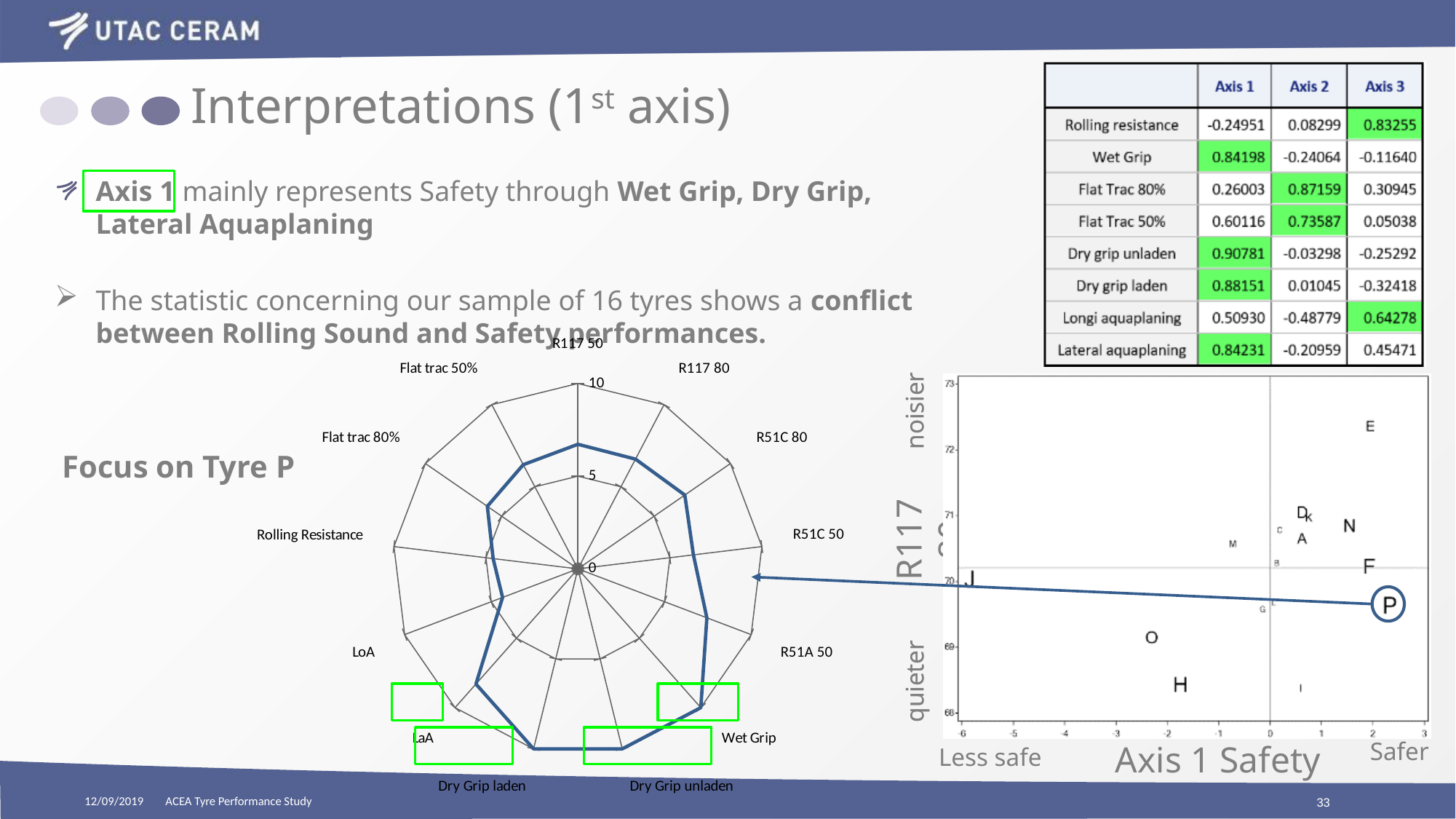
On the 'Focus on Tyre P' radar chart, is the value for R117 50 greater or less than 5? greater On the 'Focus on Tyre P' radar chart, is the value for Rolling Resistance greater or less than 10? less On the scatter chart on the right, which tyre has the lowest Axis 1 Safety value? J On the scatter chart on the right, is the Axis 1 Safety value for tyre P greater or less than 0? greater On the 'Focus on Tyre P' radar chart, which is larger, the value for Dry Grip laden or the value for Rolling Resistance? Dry Grip laden On the scatter chart on the right, which tyre has the highest R117 value? E On the 'Focus on Tyre P' radar chart, what is the maximum value shown on the radial axis? 10 What kind of chart is the chart on the right with the 'Axis 1 Safety' x axis? scatter chart What kind of chart is the 'Focus on Tyre P' chart on the left of the slide? radar chart How many categories (spokes) does the 'Focus on Tyre P' radar chart have? 13